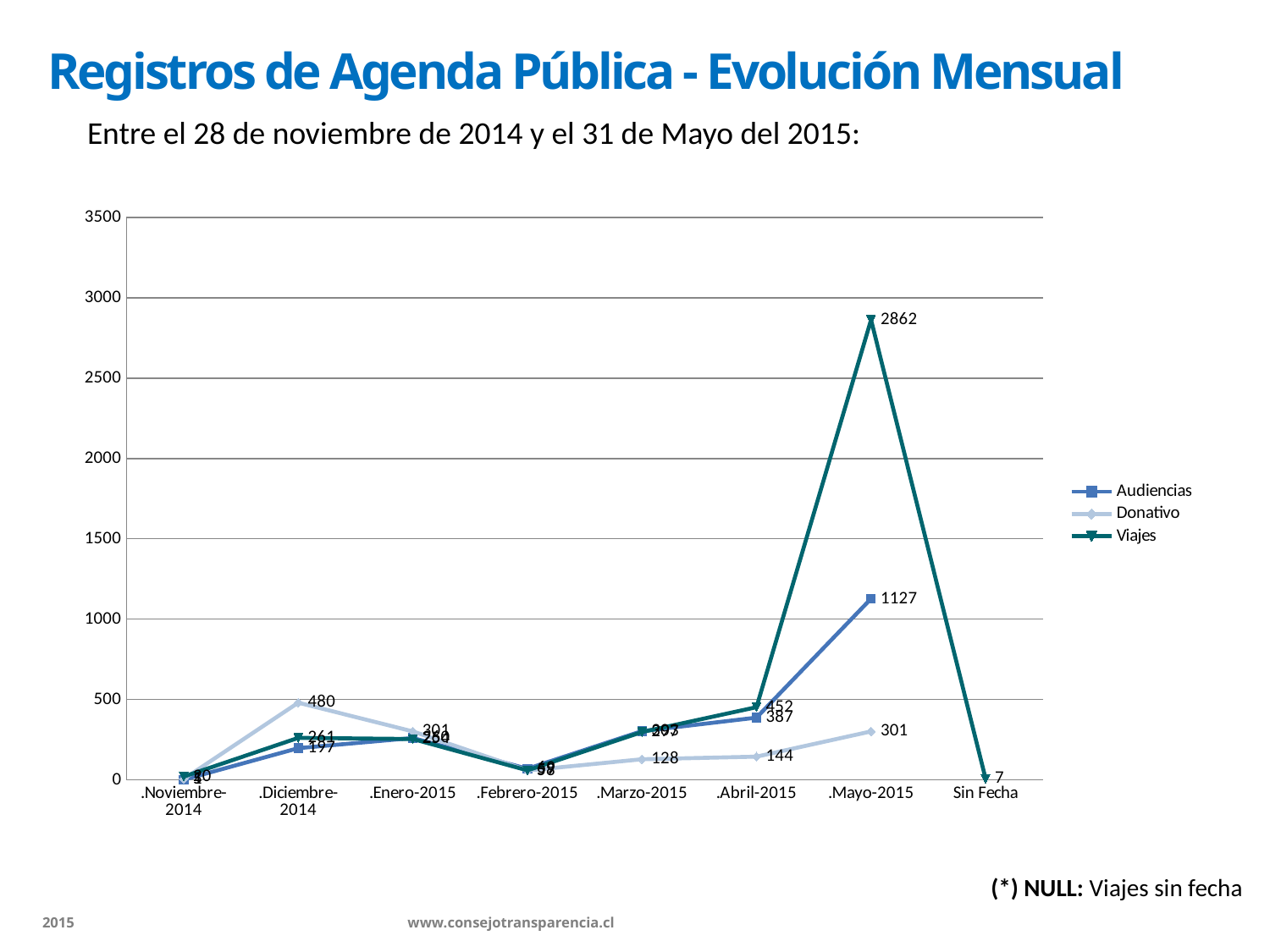
What is the value for Audiencias in Mayo-2015? 1127 Is the value for Audiencias in Mayo-2015 greater or less than 1000? greater How many categories are shown on the x axis? 8 In Abril-2015, which series has the larger value, Viajes or Donativo? Viajes What is the value for Viajes in Mayo-2015? 2862 What is the value for Donativo in Diciembre-2014? 480 What kind of chart is shown on the slide? line chart How many series does the legend list? 3 What is the value for Donativo in Abril-2015? 144 In which month does the Viajes series reach its highest value? Mayo-2015 What is the value for Viajes in the Sin Fecha category? 7 What is the difference between the Viajes and Audiencias values in Mayo-2015? 1735